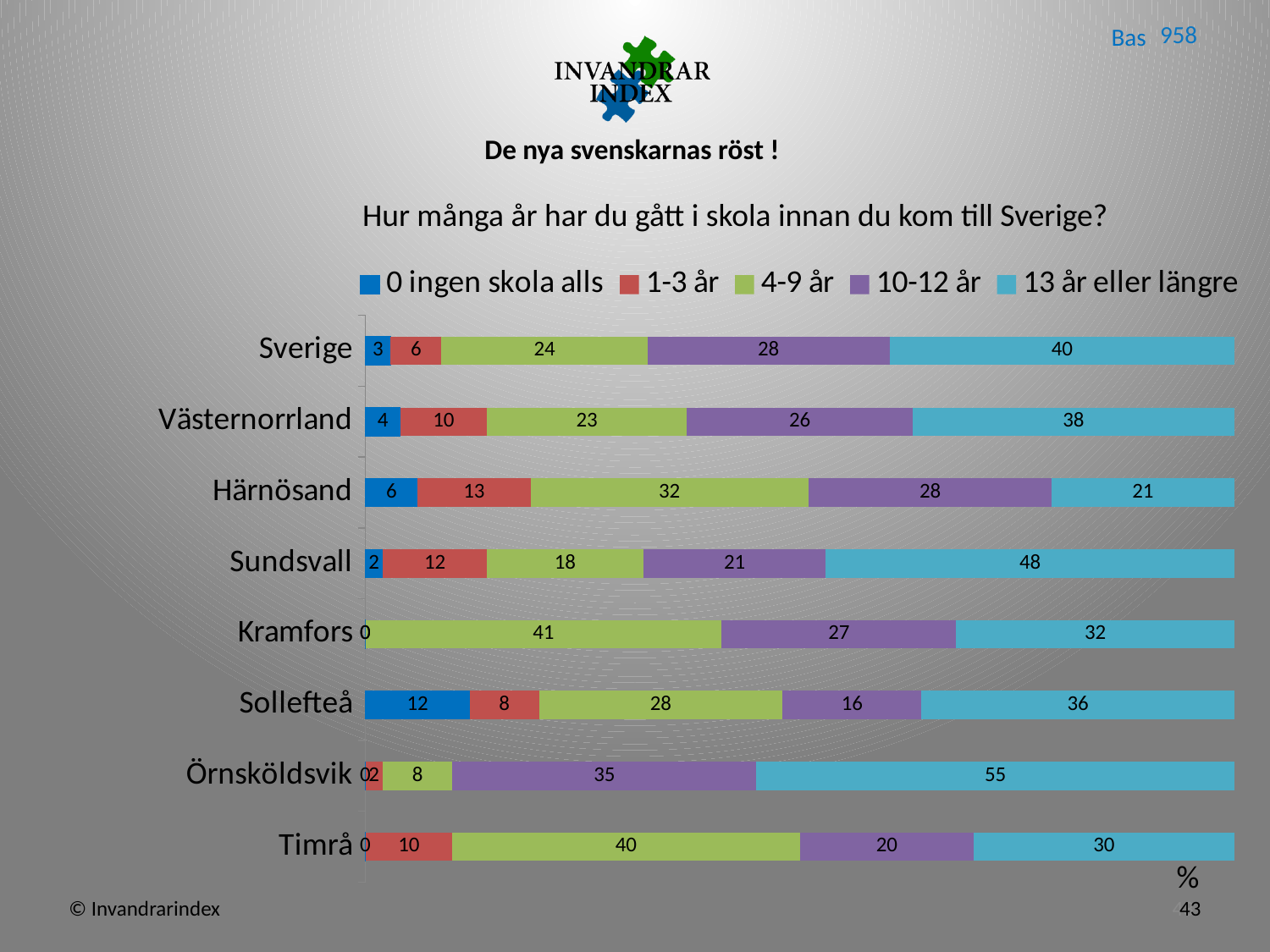
What is the value for '13 år eller längre' for Sundsvall? 48 What is the 'Bas' (base) number shown in the top right corner of the slide? 958 Which region has the lowest value for '13 år eller längre'? Härnösand What kind of chart is shown on the slide? stacked bar chart What is the value for '0 ingen skola alls' for Sollefteå? 12 What is the total of the stacked bar for Timrå? 100 How many categories (regions) are shown on the chart? 8 What is the value for '4-9 år' for Kramfors? 41 Which is larger: the '1-3 år' value for Härnösand or for Sundsvall? Härnösand How many series does the legend list? 5 What is the difference between the '10-12 år' values for Örnsköldsvik and Sollefteå? 19 Which region has the highest value for '13 år eller längre'? Örnsköldsvik